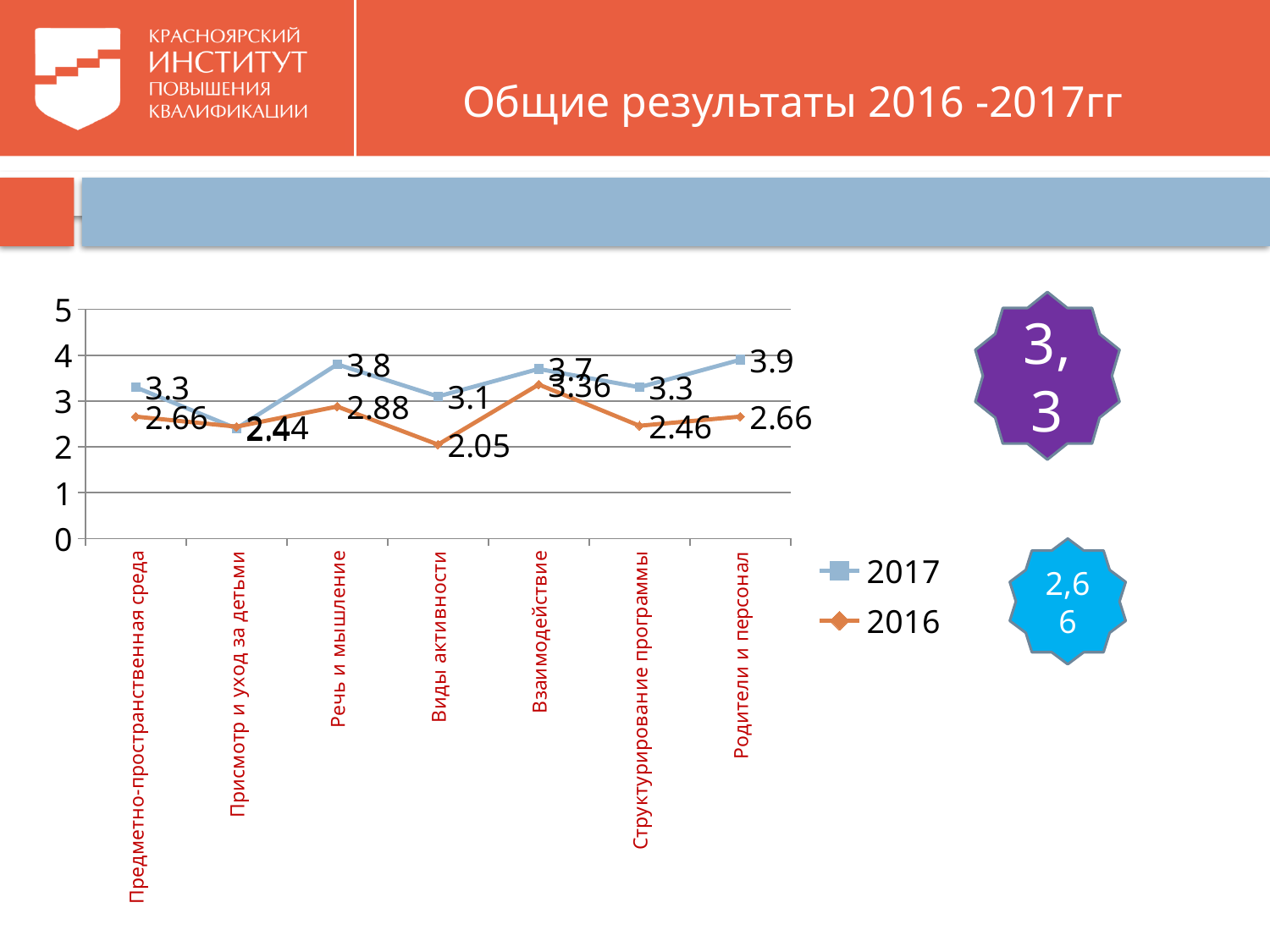
How many categories are shown on the x axis? 7 Which series is drawn in orange? 2016 Which category has the lowest 2016 value? Виды активности How many series does the legend list? 2 What is the 2017 value for Речь и мышление? 3.8 What is the 2016 value for Взаимодействие? 3.36 Which category has the highest 2017 value? Родители и персонал Which is larger for Структурирование программы, the 2017 value or the 2016 value? 2017 What is the 2016 value for Виды активности? 2.05 What kind of chart is shown on the slide? line chart What is the difference between the 2017 and 2016 values for Виды активности? 1.05 What is the 2017 value for Родители и персонал? 3.9